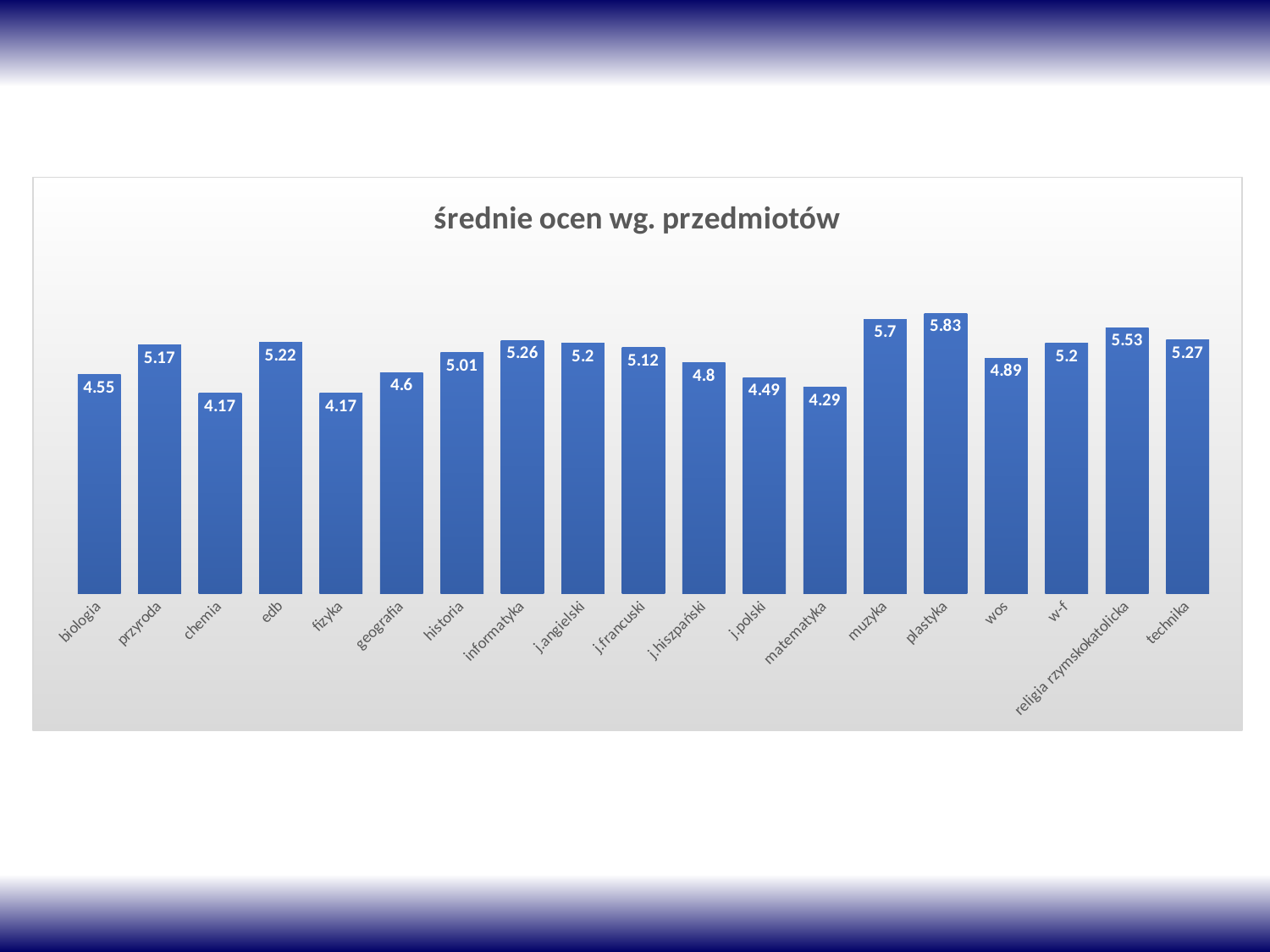
What is the title of the chart? średnie ocen wg. przedmiotów Which subject has the highest value? plastyka Which is larger, the value for technika or the value for j.polski? technika What is the difference between the values for edb and biologia? 0.67 Which is larger, the value for historia or the value for wos? historia What is the value for matematyka? 4.29 What is the value for religia rzymskokatolicka? 5.53 How many subjects are shown on the chart? 19 What is the lowest value shown on the chart? 4.17 What is the difference between the values for plastyka and muzyka? 0.13 What is the value for j.hiszpański? 4.8 What is the value for informatyka? 5.26